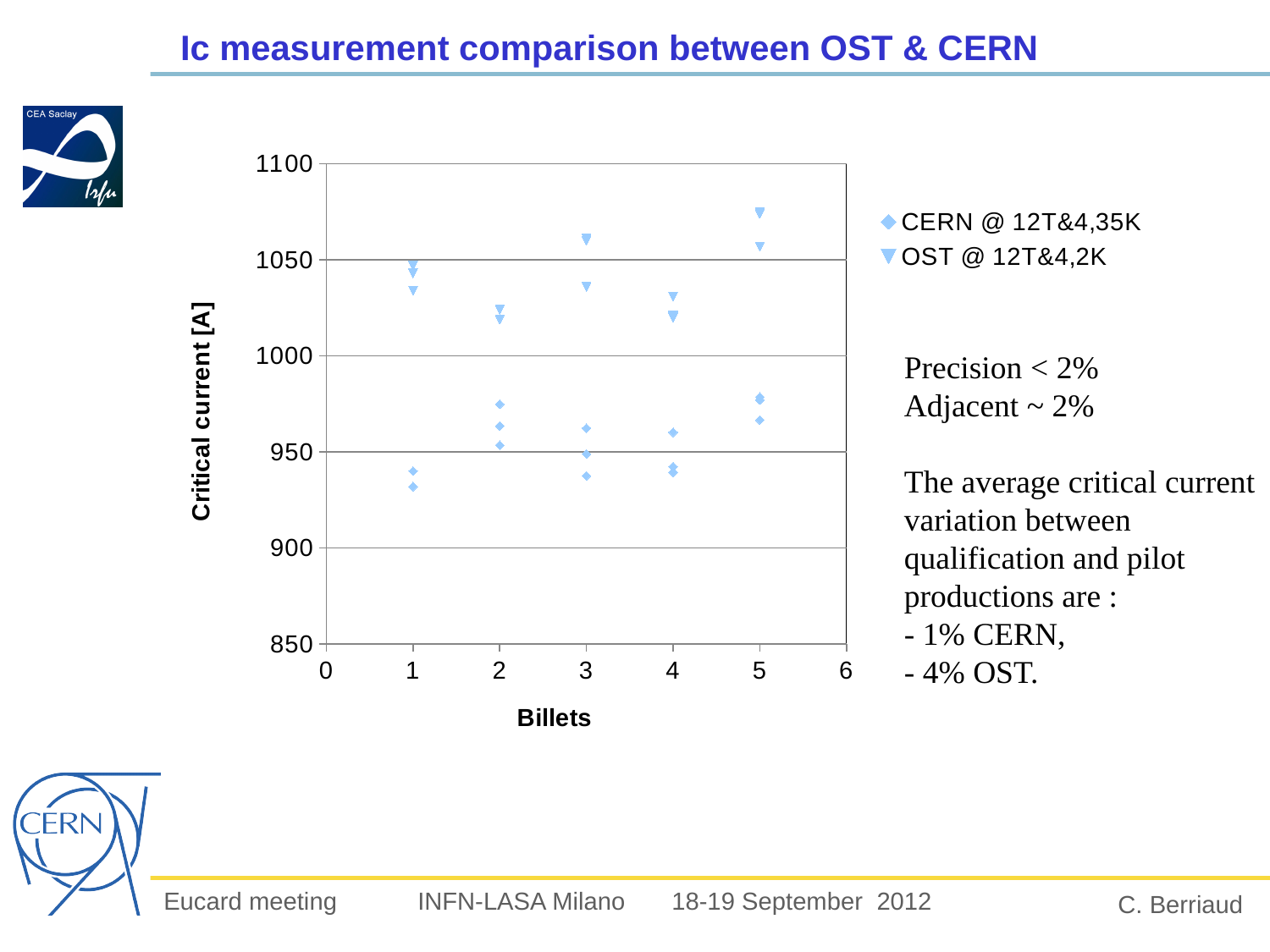
How many series does the legend list? 2 What are the two series named in the legend? CERN @ 12T&4,35K and OST @ 12T&4,2K What kind of chart is shown on the slide? scatter chart Are the OST @ 12T&4,2K values for billet 2 greater or less than 1000? greater At billet 3, which series has the higher critical current values, CERN @ 12T&4,35K or OST @ 12T&4,2K? OST @ 12T&4,2K Are the CERN @ 12T&4,35K values for billet 5 greater or less than 1000? less Which series has the lower critical current values across all billets? CERN @ 12T&4,35K What is the title of the vertical axis? Critical current [A] Are the OST @ 12T&4,2K values for billet 4 greater or less than 1000? greater How many billets have data points plotted? 5